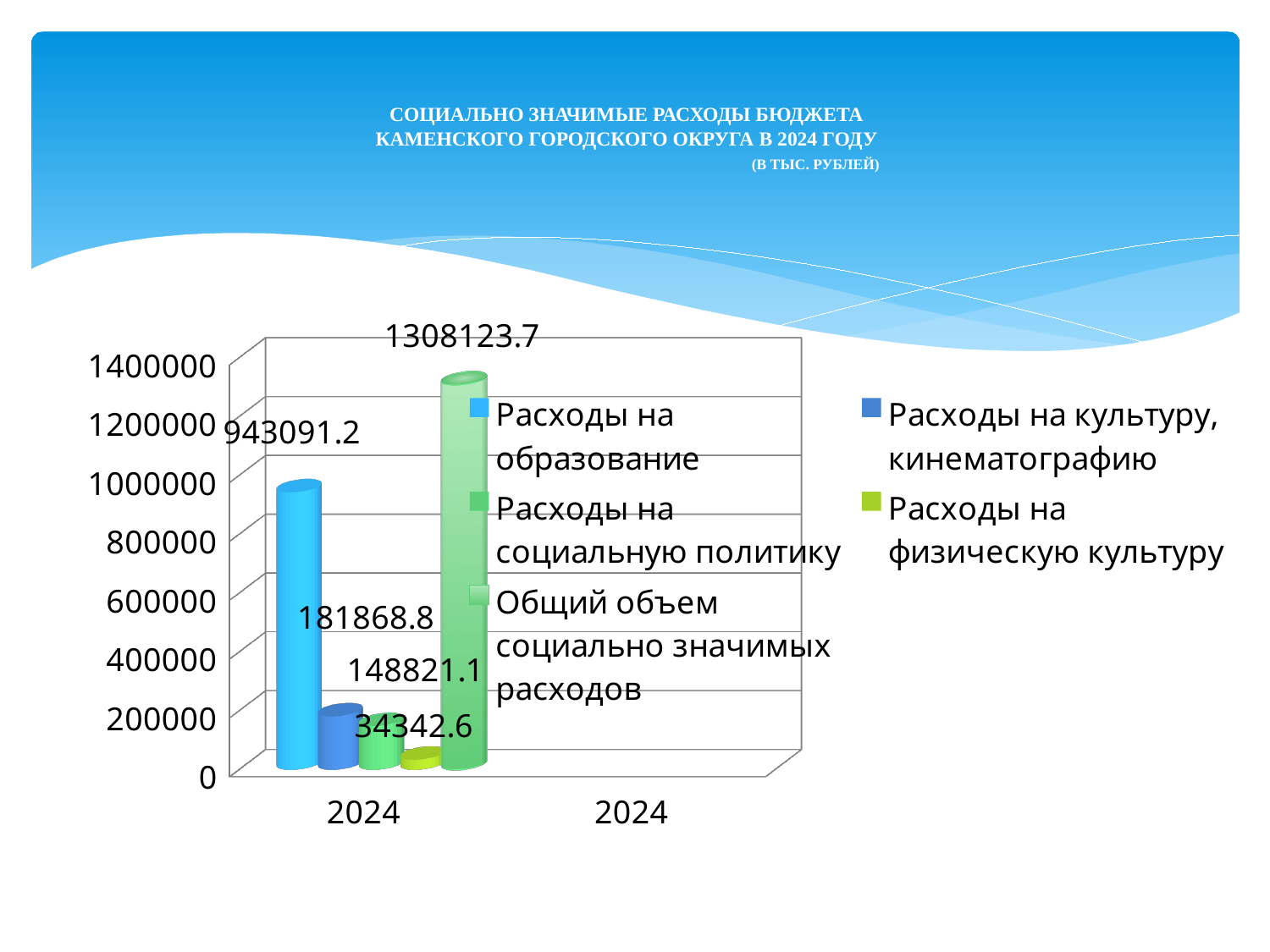
Which series has the highest value? Общий объем социально значимых расходов What is the difference between Расходы на образование and Расходы на культуру, кинематографию? 761222.4 What is the value for Расходы на культуру, кинематографию? 181868.8 How many series does the legend list? 5 Which series has the lowest value? Расходы на физическую культуру What is the value for Общий объем социально значимых расходов? 1308123.7 What is the value for Расходы на физическую культуру? 34342.6 Which is larger: Расходы на культуру, кинематографию or Расходы на социальную политику? Расходы на культуру, кинематографию What is the value for Расходы на социальную политику? 148821.1 What type of chart is shown on the slide? bar chart Is the value for Расходы на образование greater or less than 800000? greater What is the value for Расходы на образование? 943091.2